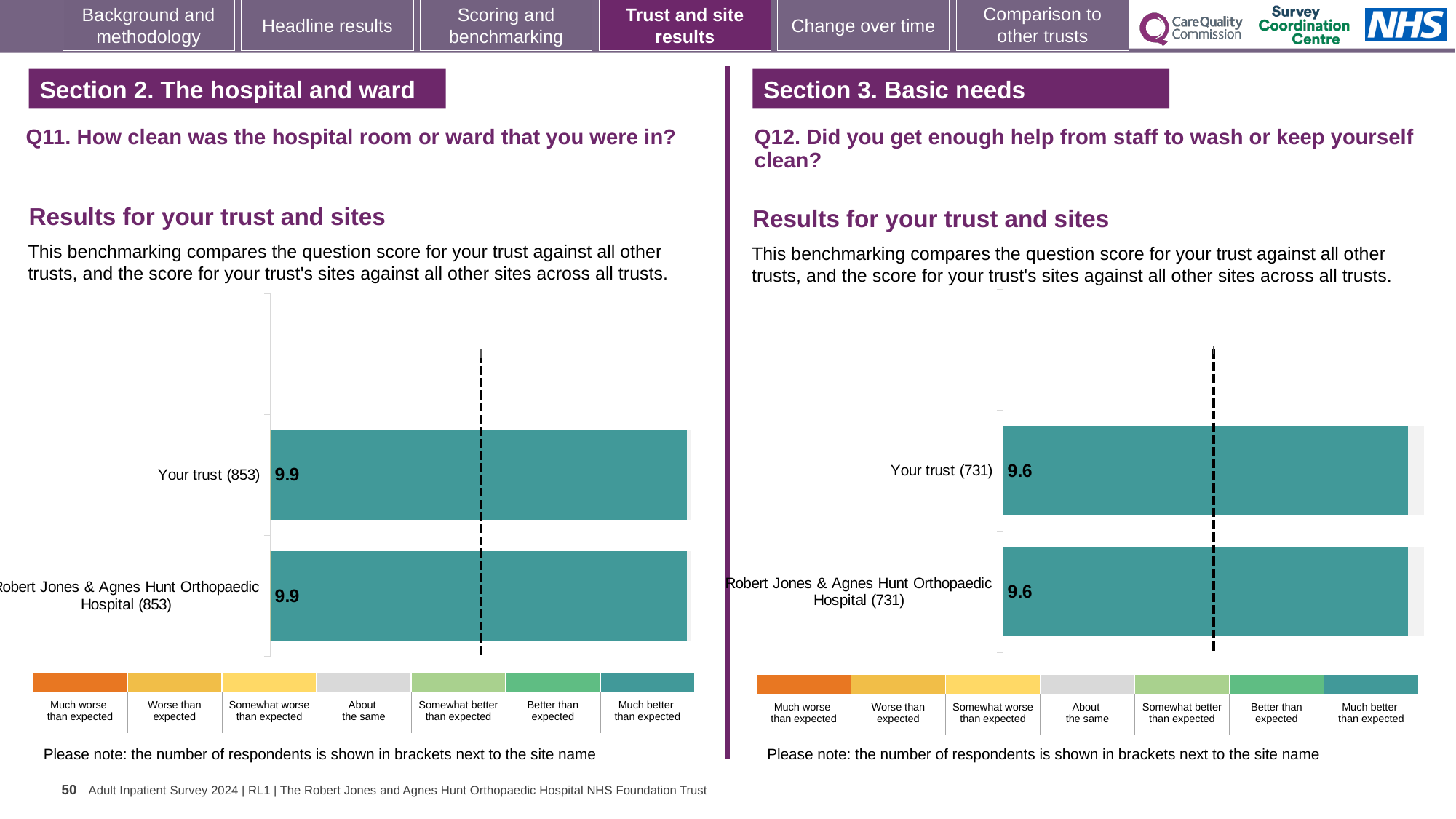
On the Q12 chart (right), what is the score for Your trust? 9.6 On the Q12 chart (right), what is the score for Robert Jones & Agnes Hunt Orthopaedic Hospital? 9.6 On the Q12 chart (right), how many respondents are shown in brackets next to Your trust? 731 Is the score for Your trust on the Q12 chart (right) larger or smaller than the score for Your trust on the Q11 chart (left)? Smaller On the Q11 chart (left), how many respondents are shown in brackets next to Your trust? 853 On the Q11 chart (left), what is the difference between the score for Your trust and the score for Robert Jones & Agnes Hunt Orthopaedic Hospital? 0.0 On the Q11 chart (left), what is the score for Robert Jones & Agnes Hunt Orthopaedic Hospital? 9.9 How many bars are plotted on the Q11 chart (left)? 2 On the Q12 chart (right), what is the difference between the score for Your trust and the score for Robert Jones & Agnes Hunt Orthopaedic Hospital? 0.0 On the Q11 chart (left), what is the score for Your trust? 9.9 How many bars are plotted on the Q12 chart (right)? 2 What kind of chart is the Q11 chart (left)? Bar chart